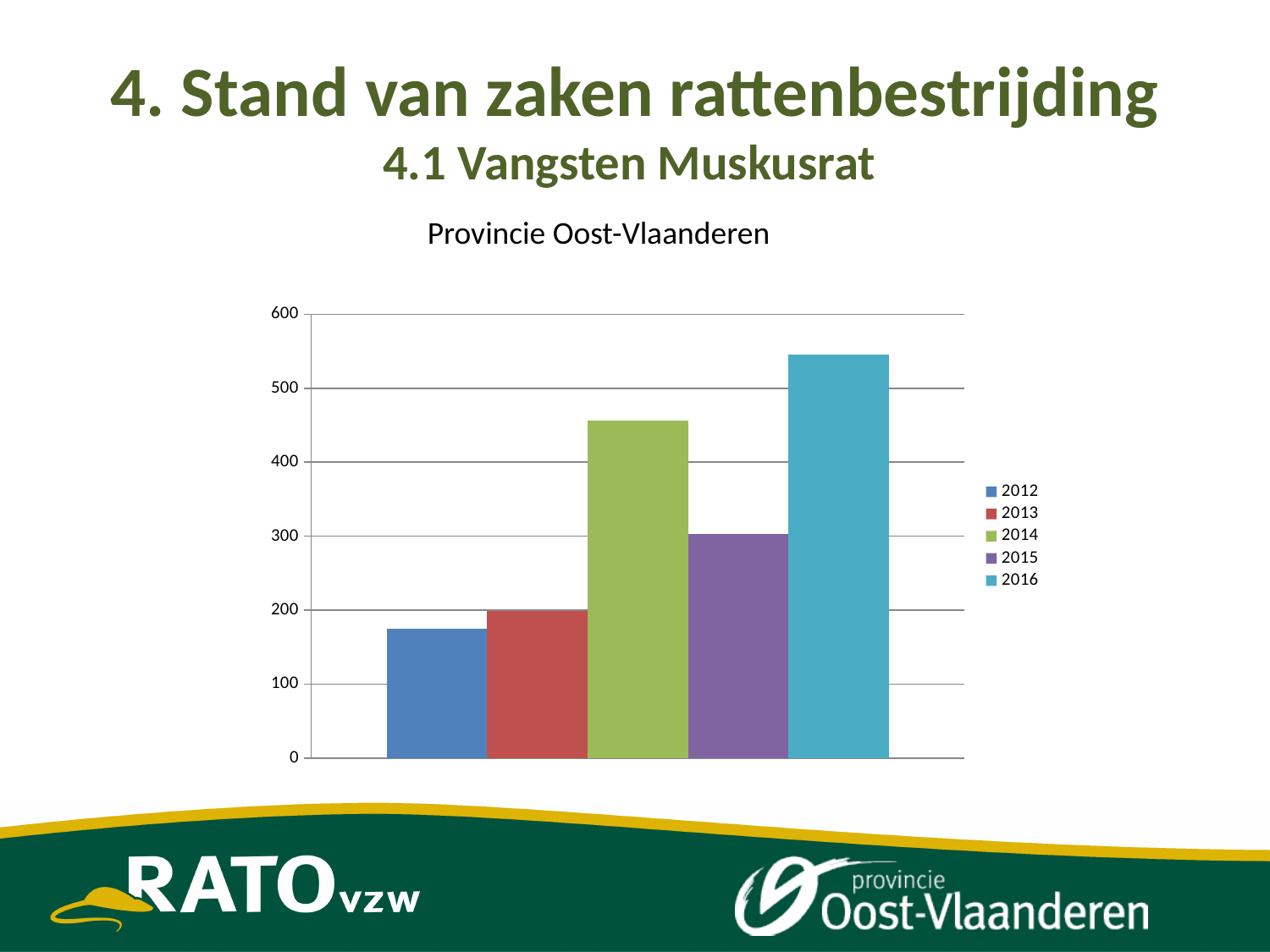
Which is larger, the value for 2012 or the value for 2013? 2013 What colour is the bar for 2014? green Is the value for 2015 greater or less than 400? less Is the value for 2012 greater or less than 200? less What is the title of the chart? Provincie Oost-Vlaanderen How many series does the legend list? 5 Which is larger, the value for 2014 or the value for 2015? 2014 Is the value for 2016 greater or less than 500? greater Which year has the highest value? 2016 What kind of chart is shown on the slide? bar chart Which year has the lowest value? 2012